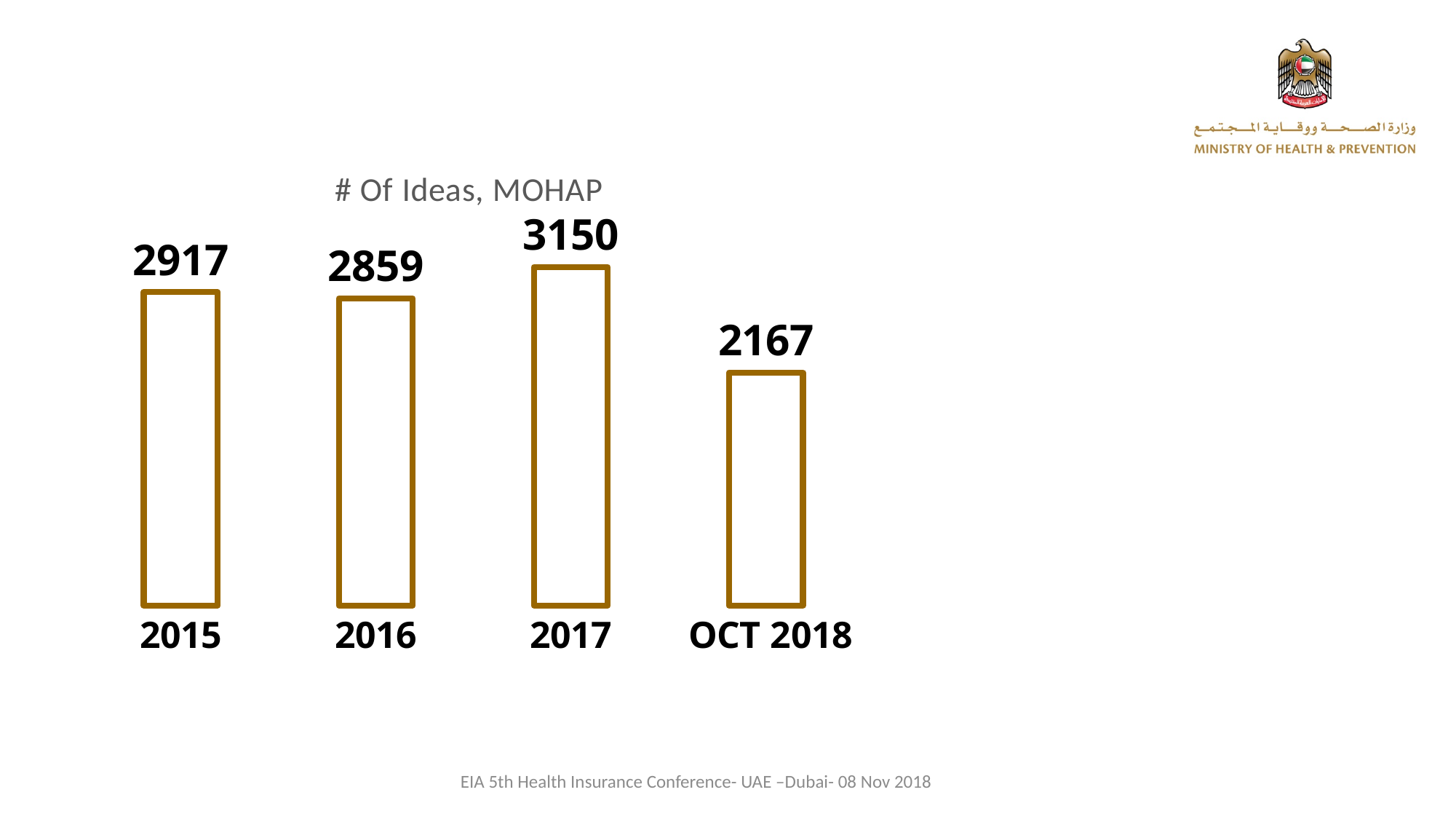
What is the number of ideas for OCT 2018? 2167 Which has more ideas, 2015 or 2016? 2015 What is the number of ideas for 2016? 2859 What is the number of ideas for 2015? 2917 What is the difference between the number of ideas in 2017 and 2016? 291 Which category has the lowest number of ideas? OCT 2018 What kind of chart is shown on the slide? Bar chart How many categories are shown on the chart? 4 What is the difference between the number of ideas in 2015 and OCT 2018? 750 What is the title of the chart? # Of Ideas, MOHAP What is the number of ideas for 2017? 3150 Which year has the highest number of ideas? 2017